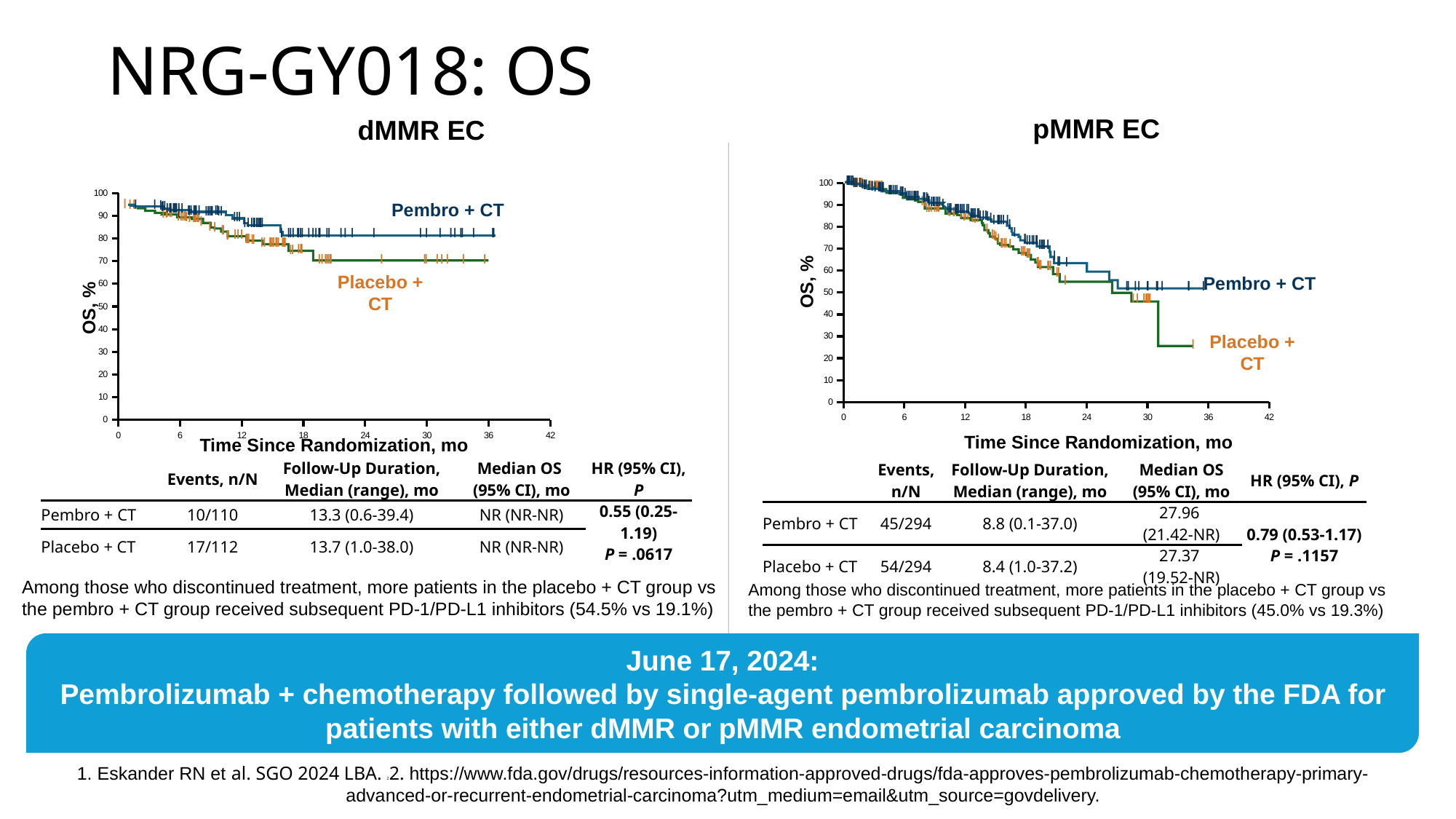
On the dMMR EC chart, is the OS value for Pembro + CT at 36 months greater or less than 70%? greater On the pMMR EC chart, is the OS value for Pembro + CT at 30 months greater or less than 40%? greater How many treatment groups are plotted on the pMMR EC chart? 2 What is the hazard ratio (95% CI) reported for OS in the dMMR EC population? 0.55 (0.25-1.19) What kind of chart is shown for dMMR EC? Line chart (Kaplan-Meier curve) On the dMMR EC chart, which group has the higher OS at 24 months, Pembro + CT or Placebo + CT? Pembro + CT On the dMMR EC chart, do the OS curves rise or fall as time since randomization increases? Fall In the pMMR EC table, what is the median OS (95% CI) for Pembro + CT? 27.96 (21.42-NR) In the dMMR EC table, what is the number of events (n/N) for Placebo + CT? 17/112 On the pMMR EC chart, which group has the higher OS at 33 months, Pembro + CT or Placebo + CT? Pembro + CT On the pMMR EC chart, is the OS value for Placebo + CT at 33 months greater or less than 40%? less